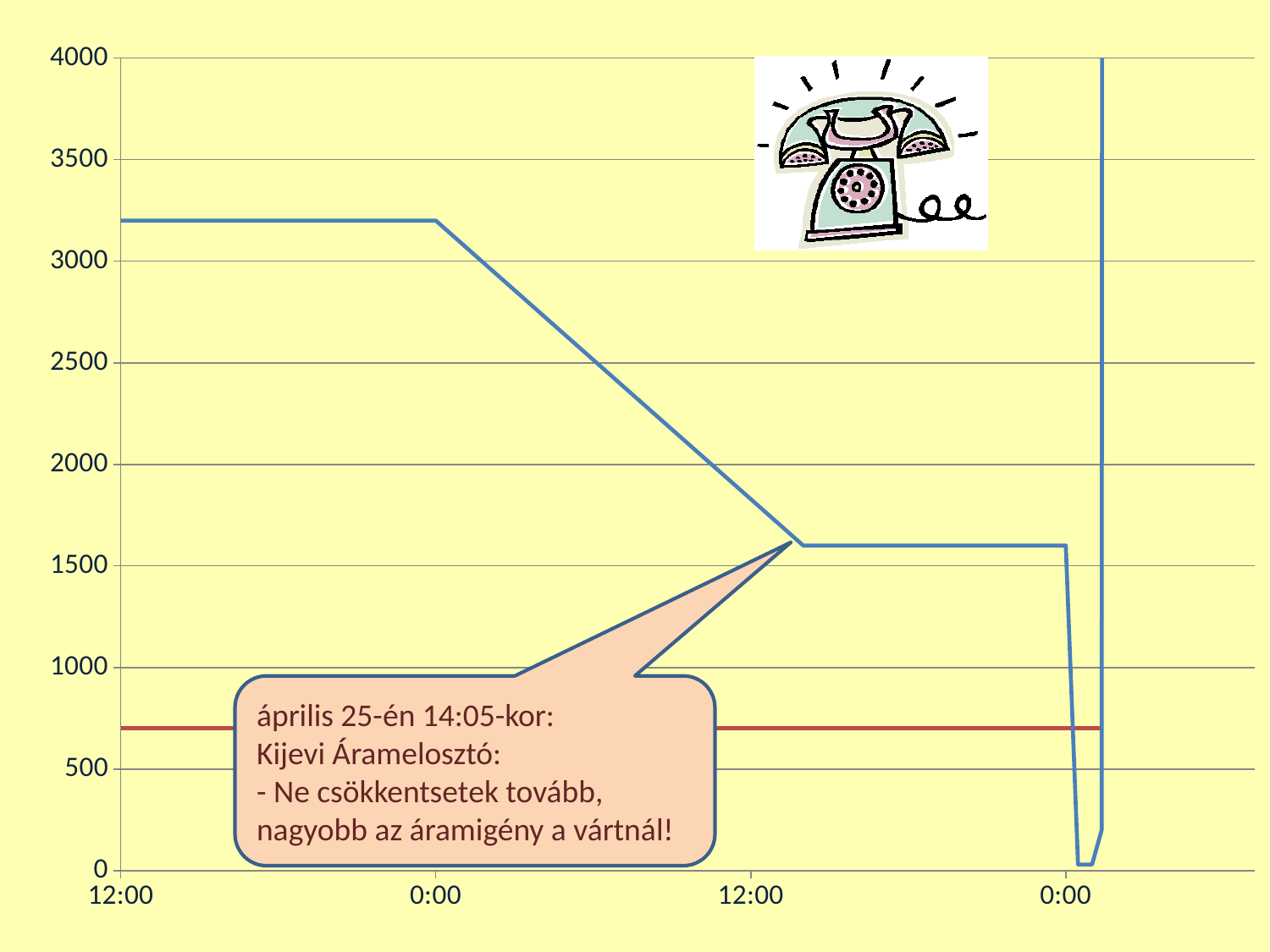
Is the value of the red horizontal line greater or less than 1000? less Which line is higher at the second 12:00 tick, the blue line or the red line? the blue line Is the value of the red horizontal line greater or less than 500? greater Between the first 12:00 tick and the first 0:00 tick, does the blue line rise, fall or stay flat? stay flat Is the value of the blue line at the second 12:00 tick greater or less than 1000? greater What kind of chart is shown on the slide? line chart How many lines are plotted on the chart? 2 Between the first 0:00 tick and the second 12:00 tick, does the blue line rise or fall? fall What is the highest value shown on the y axis? 4000